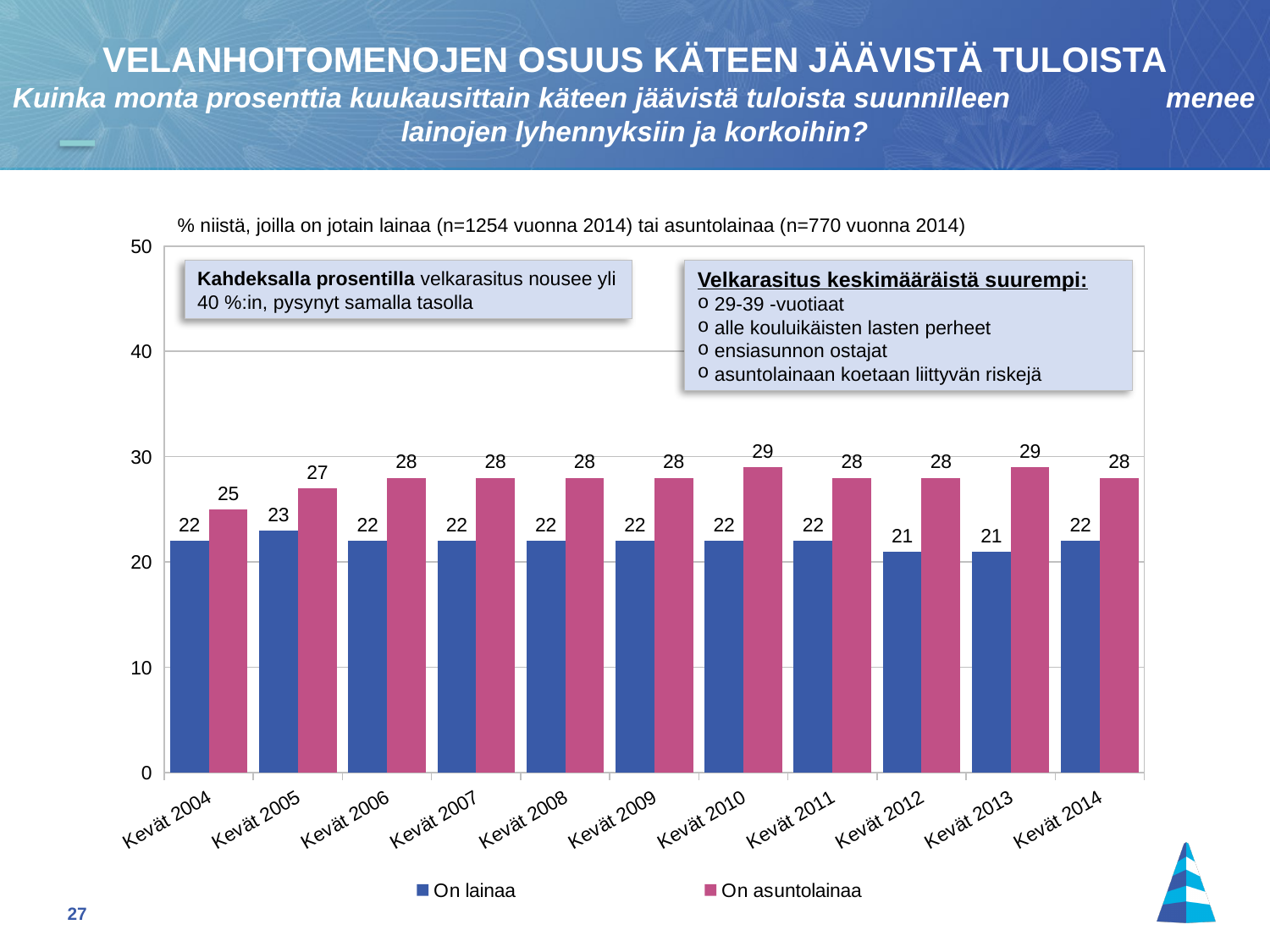
What is the value for 'On asuntolainaa' in Kevät 2010? 29 Is the value for 'On asuntolainaa' in Kevät 2007 greater or less than 30? less How many categories are shown on the x axis? 11 Which is larger in Kevät 2014: 'On lainaa' or 'On asuntolainaa'? On asuntolainaa What is the value for 'On lainaa' in Kevät 2005? 23 What is the value for 'On lainaa' in Kevät 2012? 21 Which category has the lowest value for 'On asuntolainaa'? Kevät 2004 How many series does the legend list? 2 What is the value for 'On asuntolainaa' in Kevät 2004? 25 What is the difference between 'On asuntolainaa' and 'On lainaa' in Kevät 2013? 8 What kind of chart is shown on the slide? bar chart What is the maximum value shown on the y axis? 50